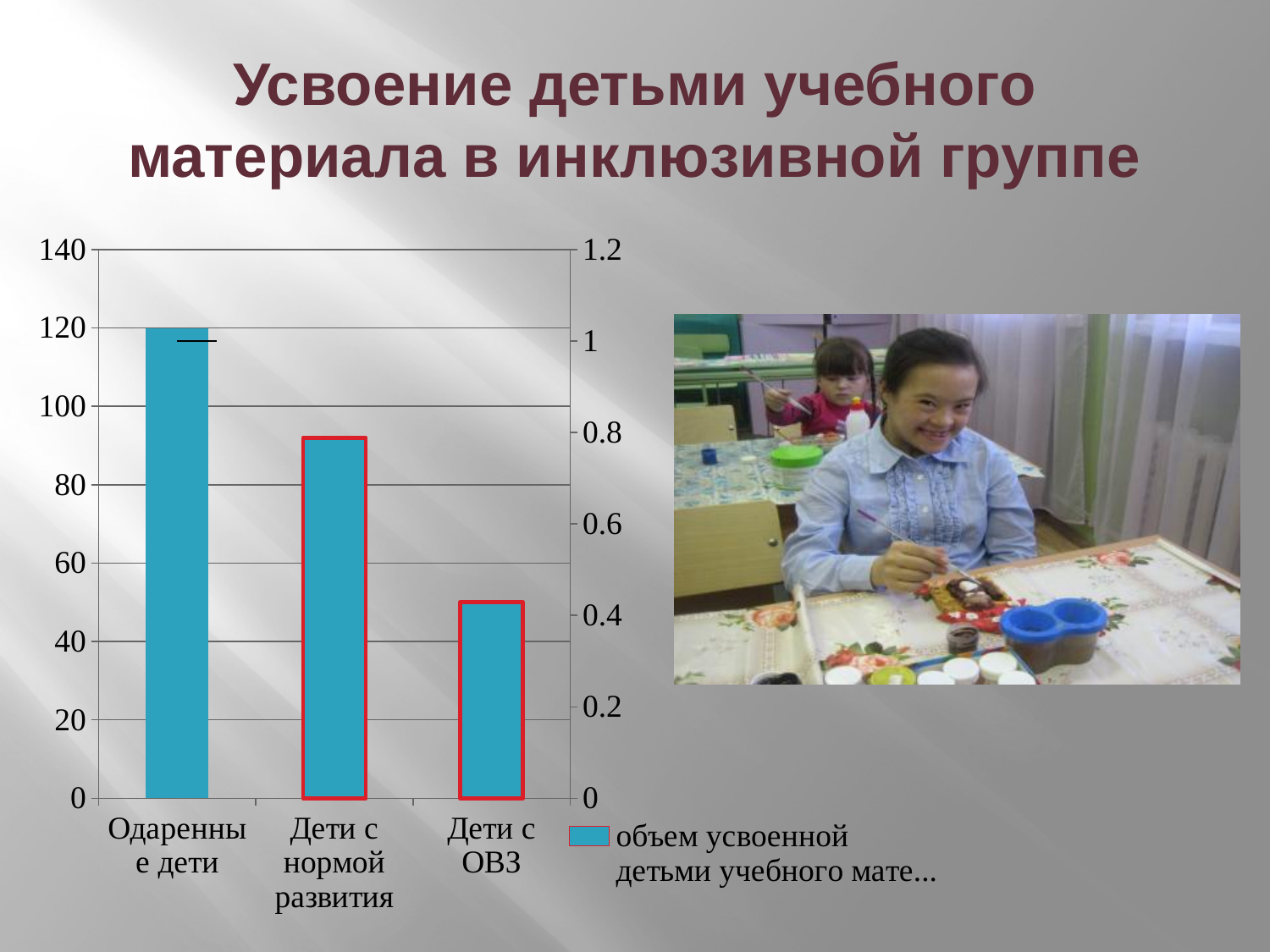
Which category has the highest bar in the chart? Одаренные дети Is the value for Дети с нормой развития greater or less than 100 on the left axis? less What is the title of the slide containing the chart? Усвоение детьми учебного материала в инклюзивной группе How many categories are shown on the x axis of the chart? 3 What type of chart is shown on the slide? bar chart Which is larger, the value for Дети с нормой развития or the value for Дети с ОВЗ? Дети с нормой развития Which category has the lowest bar in the chart? Дети с ОВЗ How many series does the chart legend list? 1 What is the value for Одаренные дети on the left axis? 120 Do the bar values rise or fall from left to right across the categories? fall Is the value for Дети с ОВЗ greater or less than 60 on the left axis? less Is the value for Дети с нормой развития greater or less than 80 on the left axis? greater